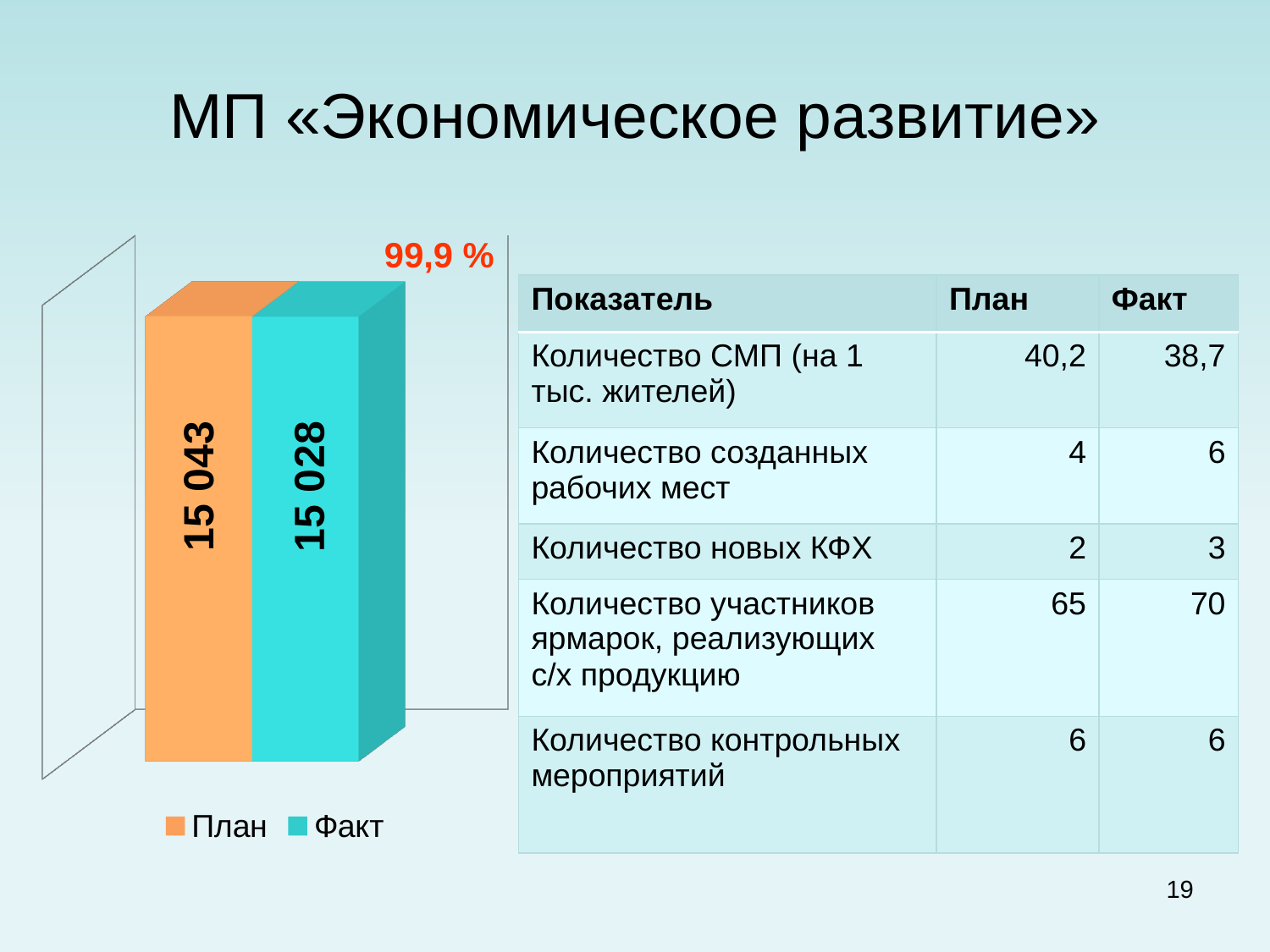
What percentage is printed above the chart? 99,9 % What is the difference between the План and Факт values in the chart? 15 What colour is the Факт bar in the chart? turquoise Which bar in the chart is higher, План or Факт? План Which series has the lowest value in the chart? Факт How many series does the chart legend list? 2 What is the value of the План bar in the chart? 15 043 What is the value of the Факт bar in the chart? 15 028 How many bars are plotted in the chart? 2 What kind of chart is shown on the slide? bar chart